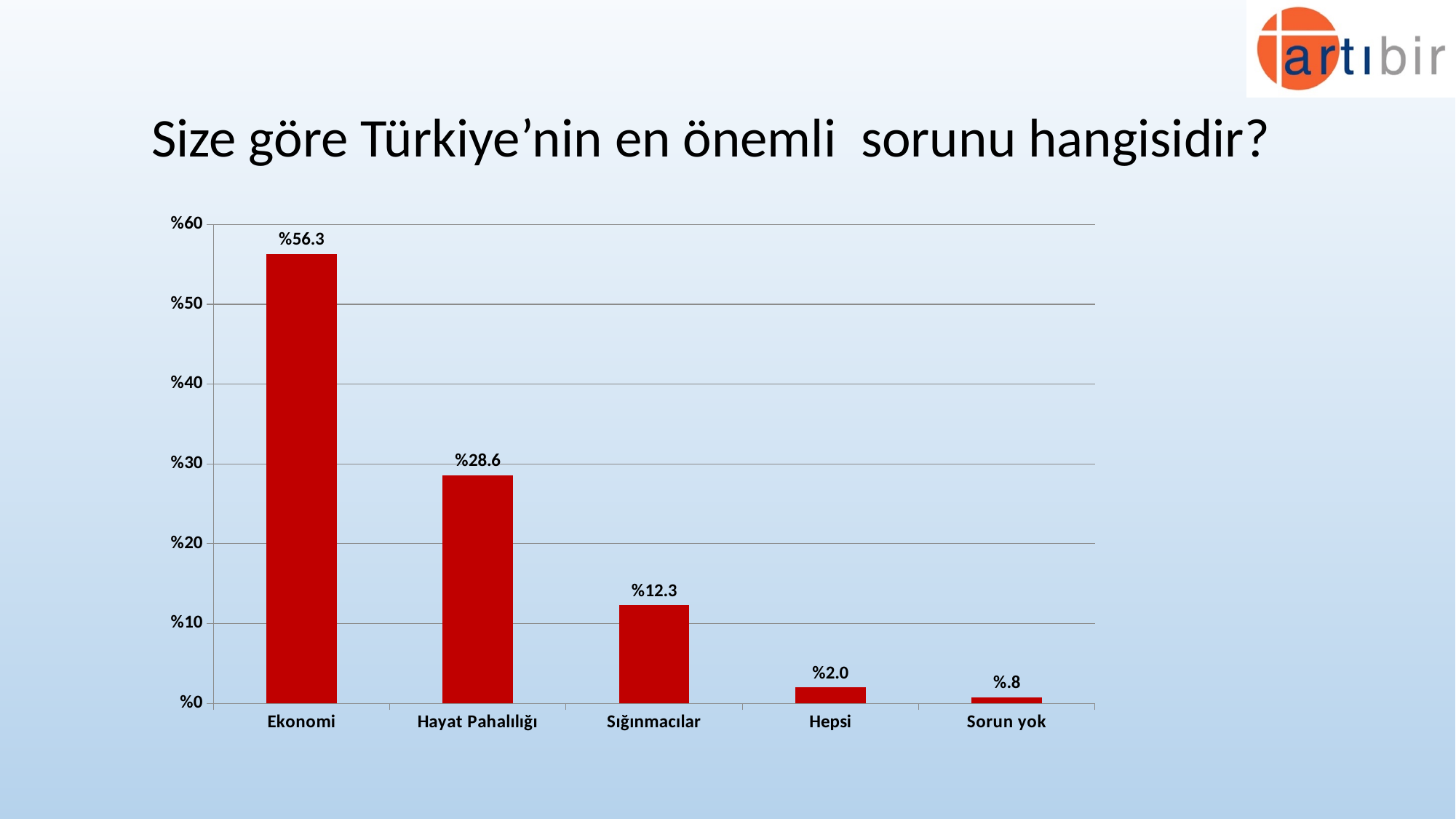
What is the value for Ekonomi? %56.3 Which category has the highest value? Ekonomi What is the title of the chart? Size göre Türkiye'nin en önemli sorunu hangisidir? Which is larger, the value for Sığınmacılar or the value for Hepsi? Sığınmacılar What is the value for Sığınmacılar? %12.3 What is the difference between the values for Ekonomi and Hayat Pahalılığı? %27.7 How many categories are shown on the x axis? 5 What kind of chart is shown on the slide? Bar chart What is the value for Hayat Pahalılığı? %28.6 Which category has the lowest value? Sorun yok What is the value for Sorun yok? %.8 What is the value for Hepsi? %2.0